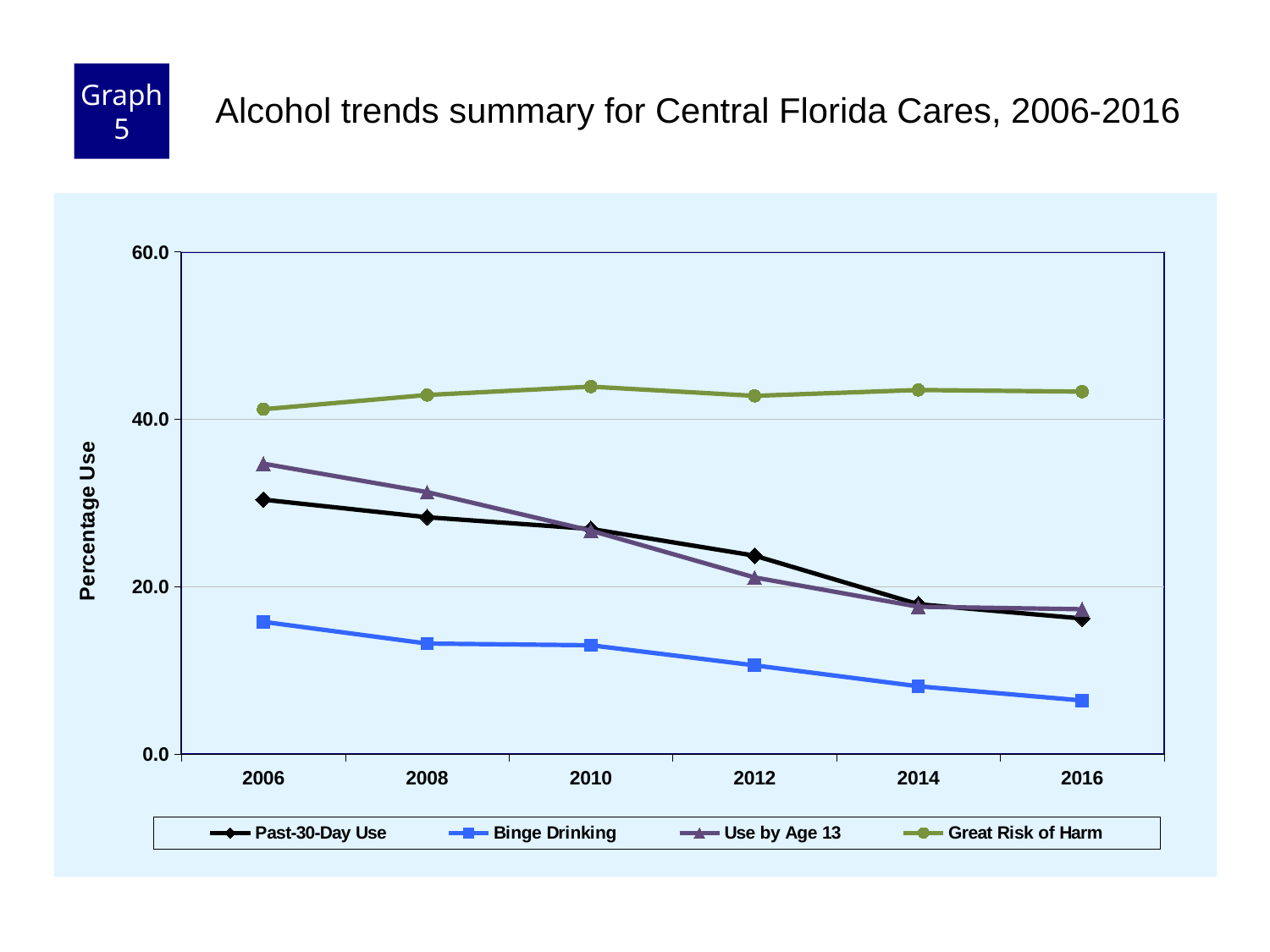
What is the label on the y axis? Percentage Use Is the value for Great Risk of Harm in 2010 greater or less than 40.0? greater Is the value for Use by Age 13 in 2006 greater or less than 40.0? less Is the value for Binge Drinking in 2016 greater or less than 20.0? less Which series has the lowest value in 2016? Binge Drinking What kind of chart is shown on the slide? line chart Which series has the highest value in 2016? Great Risk of Harm Does the Binge Drinking series rise or fall from 2006 to 2016? fall In 2006, which is larger: Use by Age 13 or Past-30-Day Use? Use by Age 13 How many years are plotted along the x axis? 6 How many series does the legend list? 4